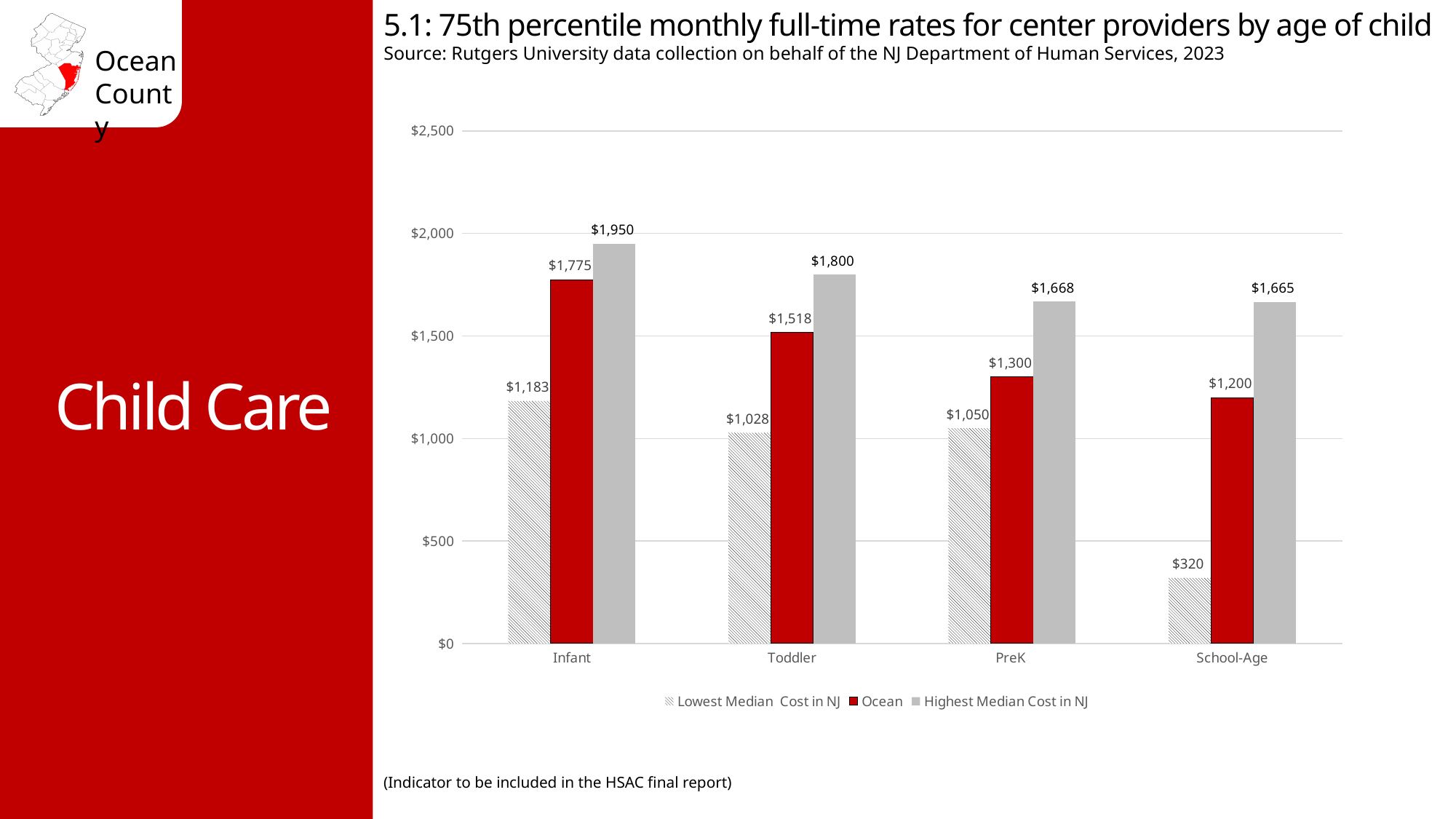
Which age group has the lowest Lowest Median Cost in NJ value? School-Age What kind of chart is shown on the slide? bar chart Which age group has the highest Ocean value? Infant What is the Lowest Median Cost in NJ for School-Age? $320 Which is larger for Toddler: the Ocean value or the Lowest Median Cost in NJ value? Ocean What is the difference between the Highest Median Cost in NJ and the Ocean value for PreK? $368 How many age groups are shown on the x axis? 4 What is the Ocean value for Infant? $1,775 Do the Ocean values rise or fall from Infant to School-Age? fall Is the Ocean value for School-Age greater or less than $1,500? less What is the Highest Median Cost in NJ for Toddler? $1,800 How many series does the legend list? 3